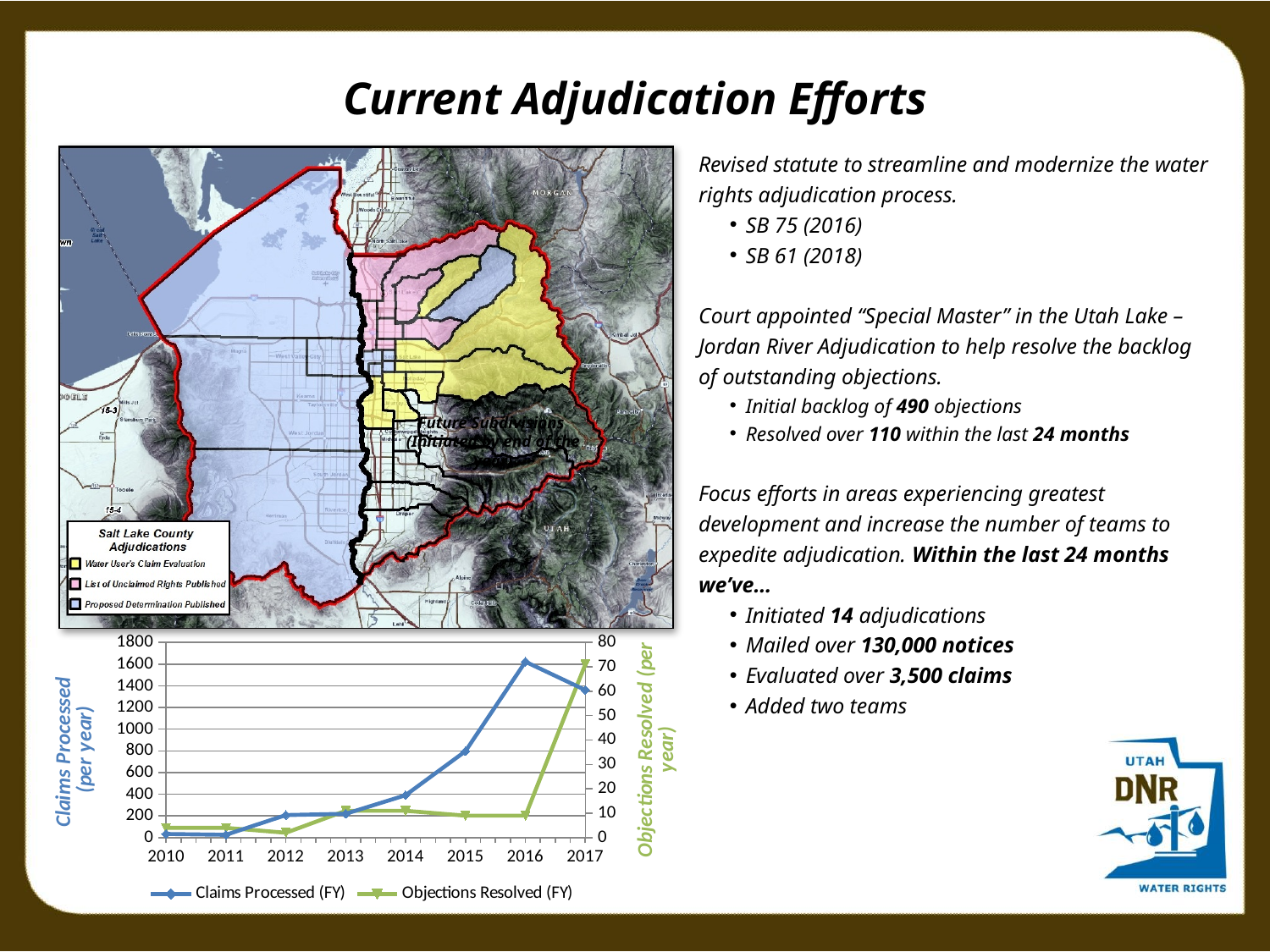
Is the value for Claims Processed (FY) in 2016 greater or less than 1400? greater Is the value for Claims Processed (FY) in 2015 greater or less than 1000? less What kind of chart is shown at the bottom left of the slide? Line chart Is the value for Objections Resolved (FY) in 2016 greater or less than 20? less In which year does the Claims Processed (FY) series reach its highest value? 2016 How many series does the legend of the line chart list? 2 Which year has the larger value for Claims Processed (FY), 2016 or 2017? 2016 In which year does the Objections Resolved (FY) series reach its highest value? 2017 How many years are plotted along the x axis of the line chart? 8 Does the Claims Processed (FY) series generally rise or fall from 2010 to 2016? Rise What is the title of the right-hand vertical axis of the line chart? Objections Resolved (per year)